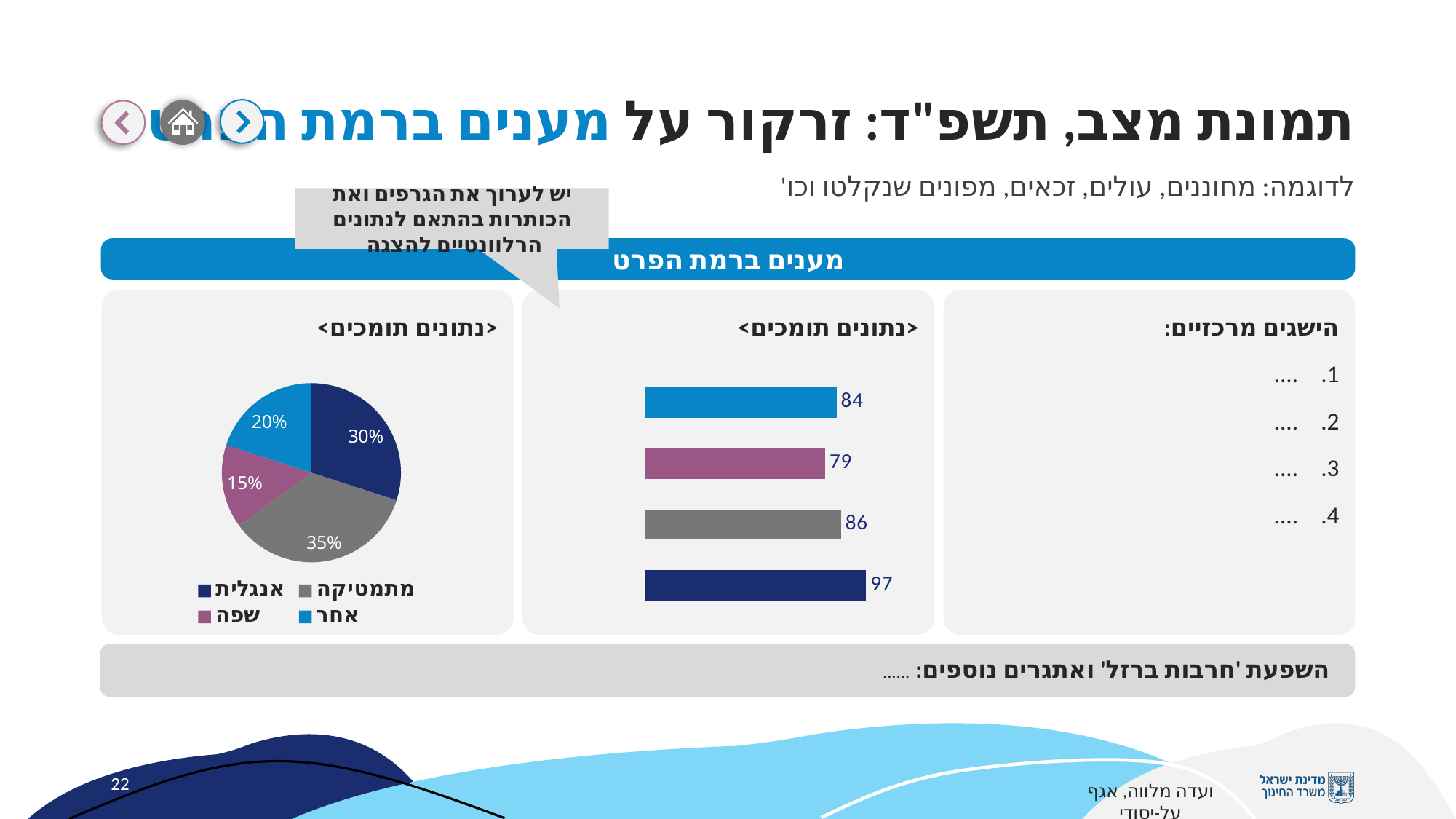
In the bar chart in the middle, which is larger: the gray bar or the purple bar? the gray bar In the pie chart on the left, what share does שפה have? 15% In the bar chart in the middle, what is the value of the bottom (dark blue) bar? 97 In the pie chart on the left, which category has the smallest slice? שפה In the pie chart on the left, what share does מתמטיקה have? 35% In the pie chart on the left, what is the difference between the shares of מתמטיקה and אחר? 15% In the pie chart on the left, which category has the largest slice? מתמטיקה What type of chart is shown in the middle panel? bar chart In the bar chart in the middle, what is the value of the top bar? 84 In the pie chart on the left, how many slices are there? 4 In the pie chart on the left, what share does אנגלית have? 30% In the bar chart in the middle, what is the difference between the longest and shortest bars? 18